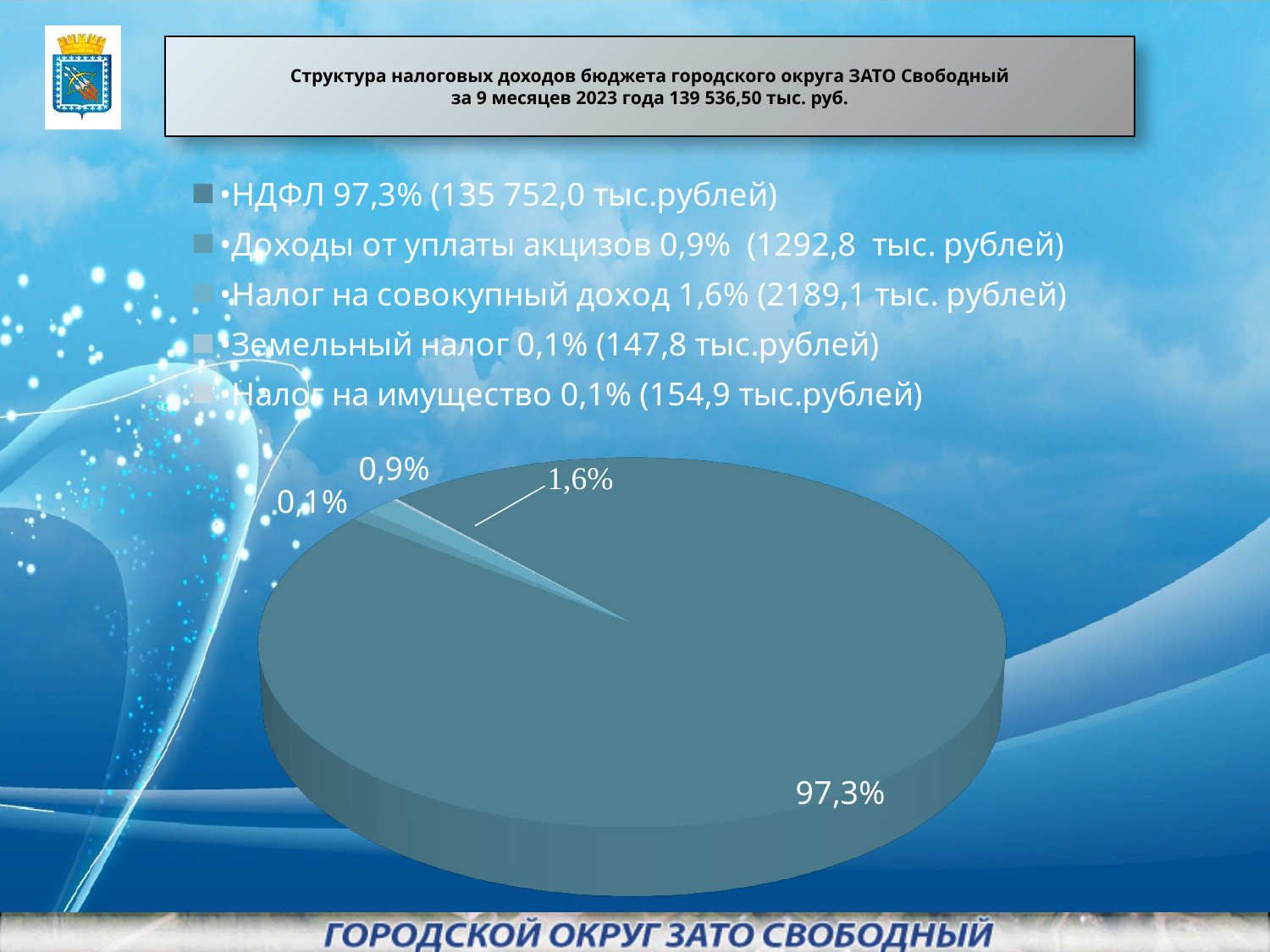
What share of the pie chart does the largest slice represent? 97,3% What kind of chart is shown on the slide? pie chart What share does Земельный налог have in the pie chart? 0,1% Which tax category accounts for 97,3% of the tax revenue shown in the pie chart? НДФЛ What is the total tax revenue amount stated in the slide title? 139 536,50 тыс. руб. What is the difference between the share for Налог на совокупный доход (1,6%) and the share for Доходы от уплаты акцизов (0,9%)? 0,7% What share does Налог на совокупный доход have in the pie chart? 1,6% What share does Доходы от уплаты акцизов have in the pie chart? 0,9% What is the difference between the share for НДФЛ (97,3%) and the share for Налог на совокупный доход (1,6%)? 95,7% What amount in thousand rubles is given for НДФЛ in the bullet list? 135 752,0 тыс.рублей How many tax categories are listed in the bullet list above the pie chart? 5 Which is larger in the pie chart: the share for Налог на совокупный доход or the share for Доходы от уплаты акцизов? Налог на совокупный доход